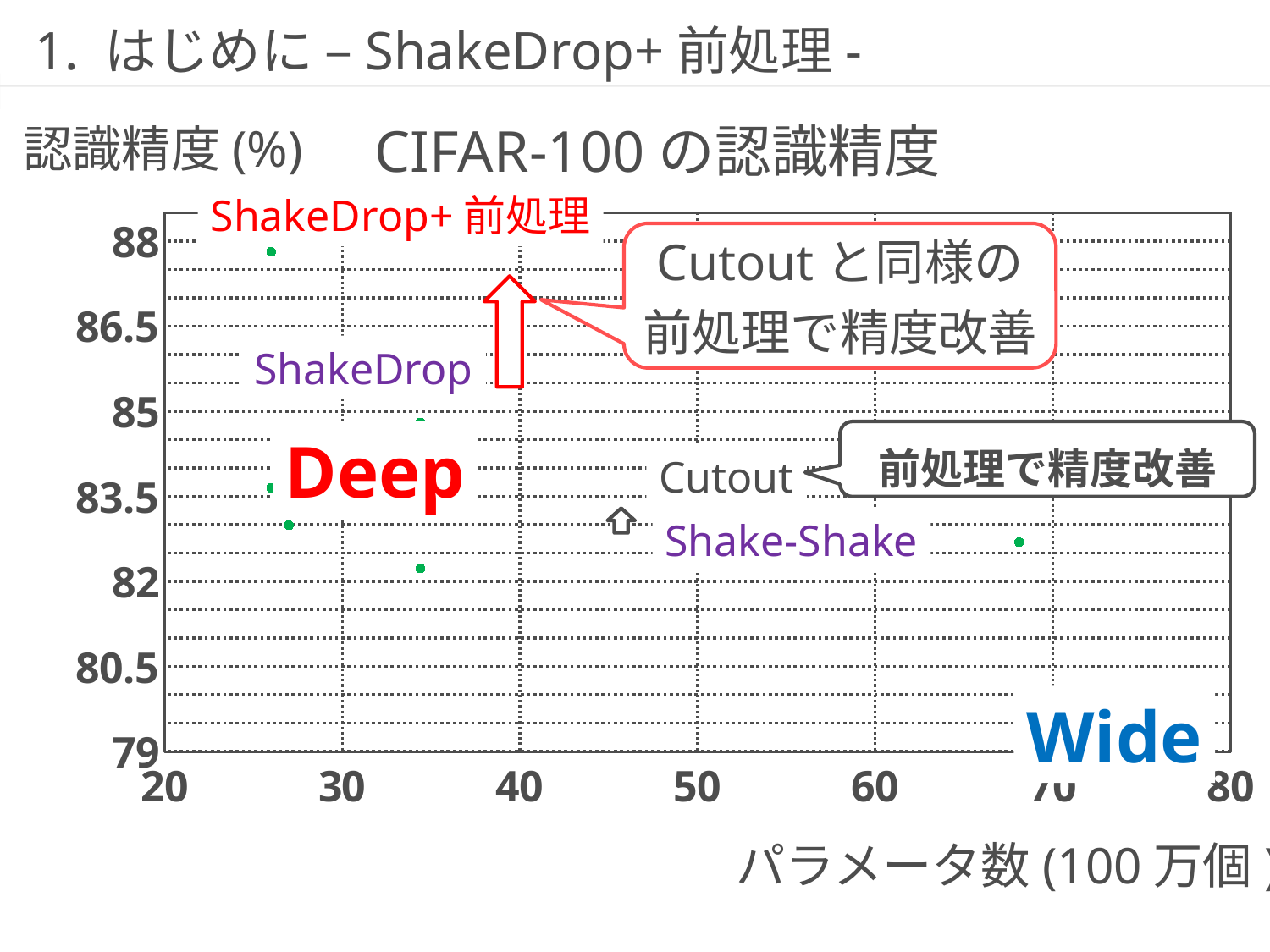
Is the accuracy of the ShakeDrop+ 前処理 point greater or less than 86.5? greater What kind of chart is shown on the slide? scatter plot Is the accuracy of the Shake-Shake point greater or less than 82? greater What is the title of the chart? CIFAR-100 の認識精度 Is the accuracy of the Shake-Shake point greater or less than 83.5? less What is the label of the x axis? パラメータ数 (100 万個) What is the lowest value shown on the y axis? 79 Which has higher accuracy, ShakeDrop+ 前処理 or Shake-Shake? ShakeDrop+ 前処理 Which labeled method has the highest recognition accuracy in the chart? ShakeDrop+ 前処理